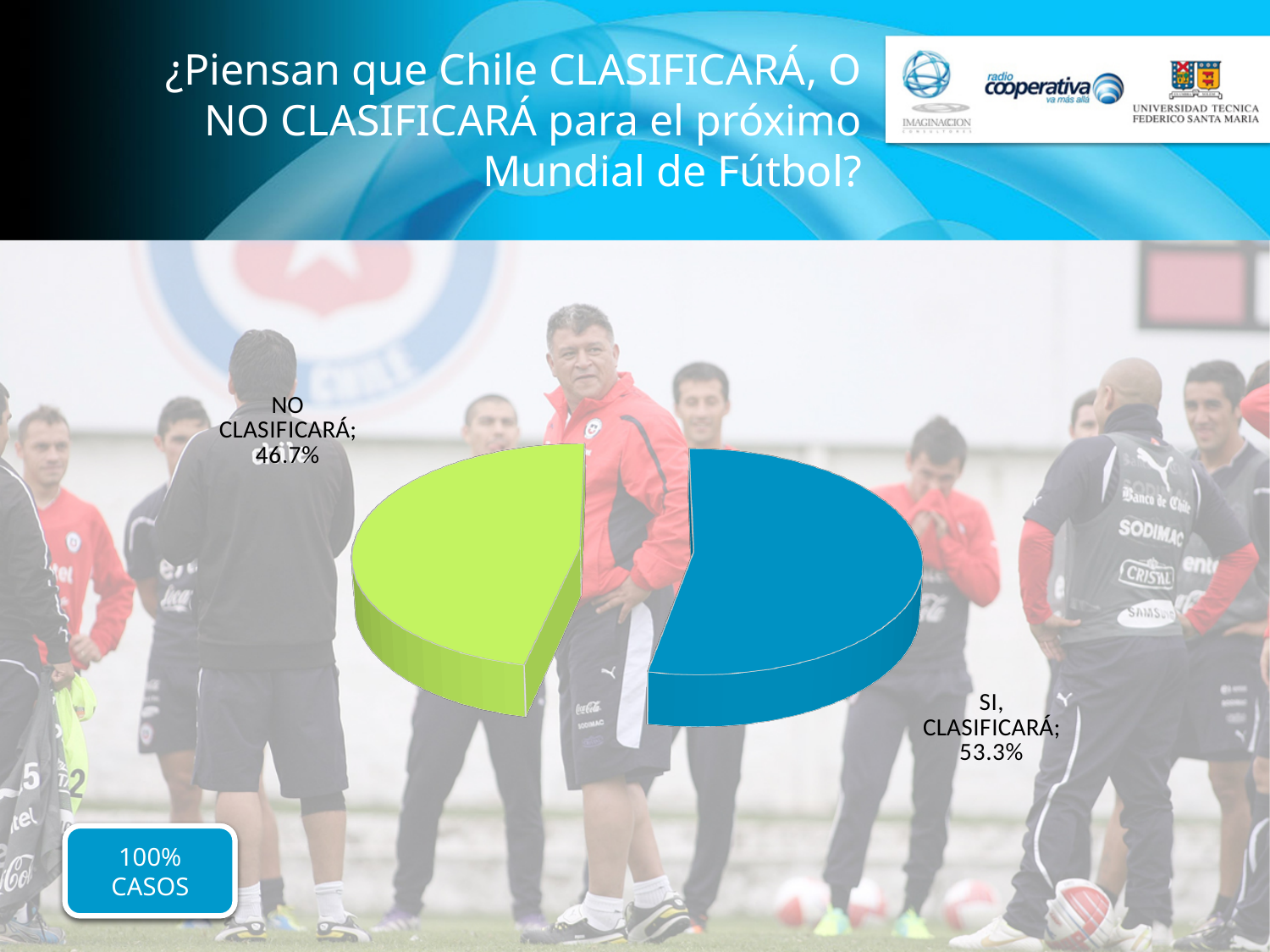
Which response has the larger share of the pie? SI, CLASIFICARÁ Is the share for "SI, CLASIFICARÁ" larger or smaller than the share for "NO CLASIFICARÁ"? larger How many slices does the pie chart have? 2 What type of chart is shown on the slide? pie chart What colour is the "SI, CLASIFICARÁ" slice? blue What is the difference in percentage points between "SI, CLASIFICARÁ" and "NO CLASIFICARÁ"? 6.6 What percentage of respondents answered "SI, CLASIFICARÁ"? 53.3% Is the share for "NO CLASIFICARÁ" greater or less than 50%? less What colour is the "NO CLASIFICARÁ" slice? green Which response has the smaller share of the pie? NO CLASIFICARÁ What percentage of respondents answered "NO CLASIFICARÁ"? 46.7% What is the total of the two slices shown in the pie chart? 100%